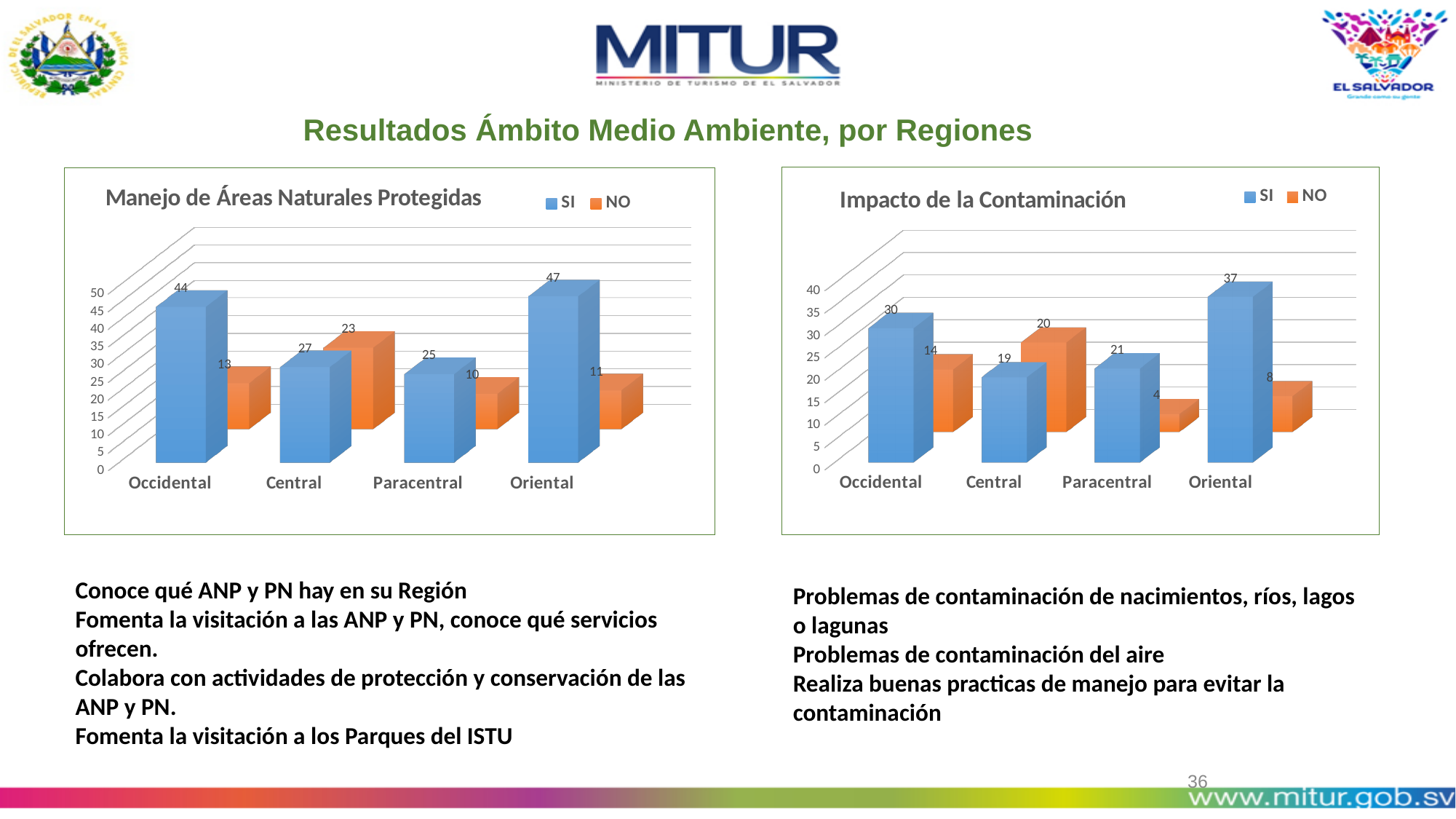
In the 'Impacto de la Contaminación' chart, is the SI value for Central larger or smaller than the NO value for Central? smaller In the 'Impacto de la Contaminación' chart, what is the SI value for Paracentral? 21 In the 'Manejo de Áreas Naturales Protegidas' chart, what is the difference between the SI and NO values for Oriental? 36 In the 'Manejo de Áreas Naturales Protegidas' chart, which region has the highest SI value? Oriental In the 'Impacto de la Contaminación' chart, what is the difference between the SI values for Oriental and Occidental? 7 In the 'Manejo de Áreas Naturales Protegidas' chart, what is the SI value for Occidental? 44 In the 'Impacto de la Contaminación' chart, what is the NO value for Oriental? 8 In the 'Manejo de Áreas Naturales Protegidas' chart, which region has the lowest NO value? Paracentral In the 'Impacto de la Contaminación' chart, which region has the lowest NO value? Paracentral What type of chart is 'Manejo de Áreas Naturales Protegidas'? Bar chart How many regions are shown on the x axis of the 'Impacto de la Contaminación' chart? 4 In the 'Manejo de Áreas Naturales Protegidas' chart, what is the NO value for Central? 23